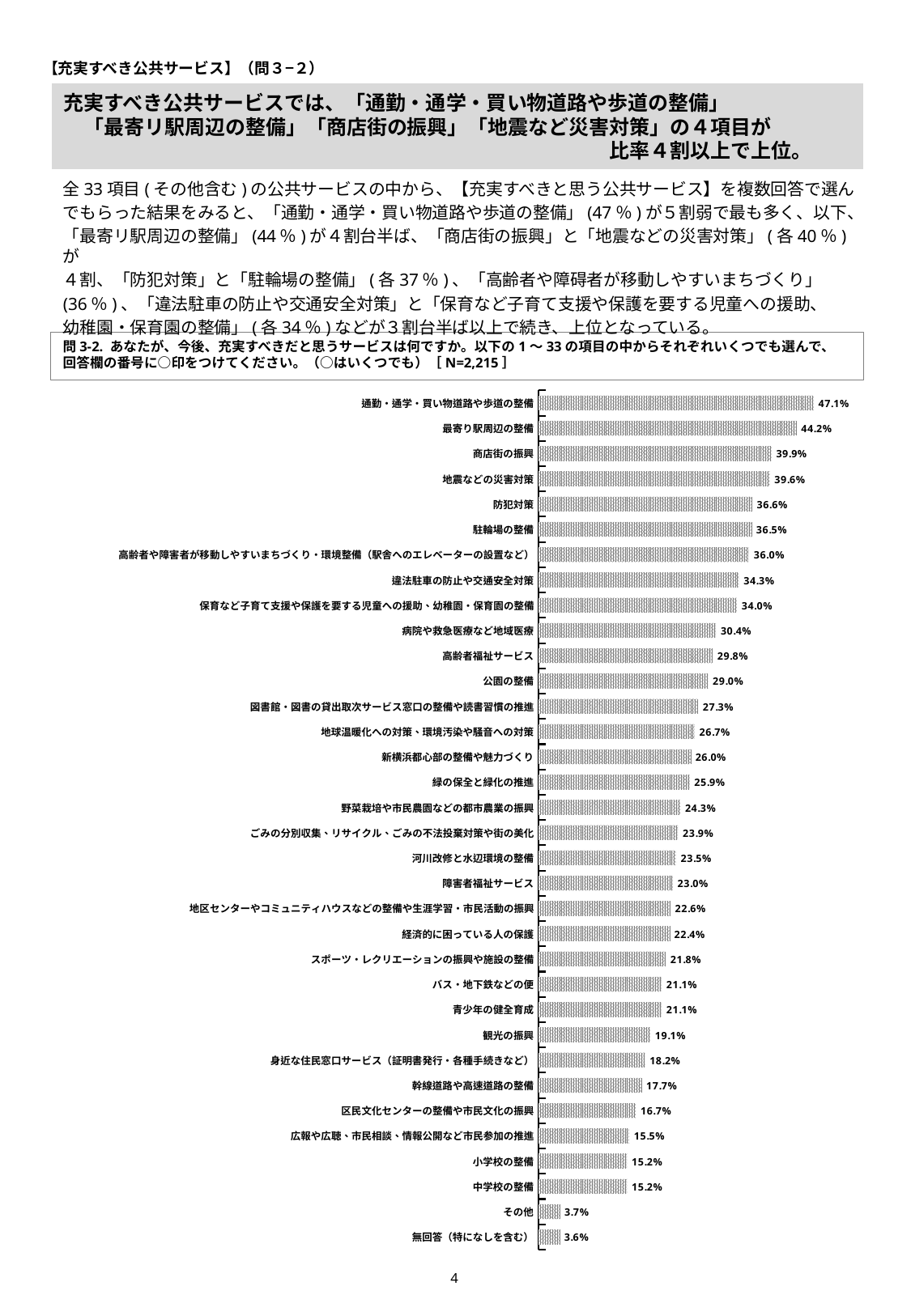
What is the value for 通勤・通学・買い物道路や歩道の整備? 47.1% What is the value for 病院や救急医療など地域医療? 30.4% What kind of chart is shown on the slide? Bar chart What is the difference between 小学校の整備 and その他? 11.5% What is the value for 観光の振興? 19.1% What is the value for 最寄り駅周辺の整備? 44.2% Which is larger, 商店街の振興 or 公園の整備? 商店街の振興 Which category has the lowest value? 無回答（特になしを含む） What is the sample size (N) stated in the question box above the chart? N=2,215 Which category has the highest value? 通勤・通学・買い物道路や歩道の整備 What is the difference between 通勤・通学・買い物道路や歩道の整備 and 最寄り駅周辺の整備? 2.9% How many bars are shown in the chart? 34